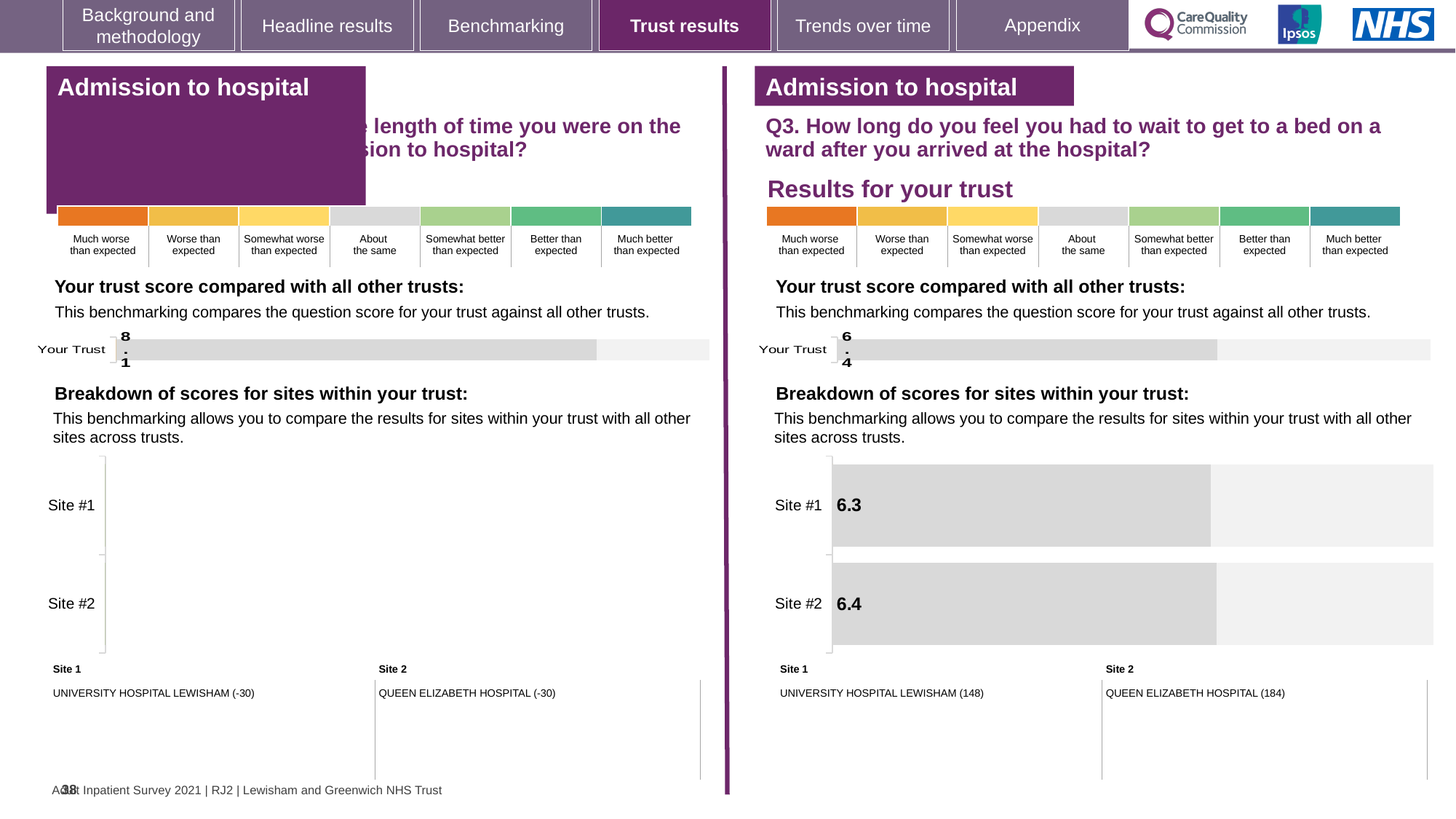
In the right-hand panel (Q3) site breakdown chart, what is the difference between the Site #2 and Site #1 scores? 0.1 In the right-hand panel (Q3) site breakdown chart, what is the score for Site #1? 6.3 In the right-hand panel (Q3), which hospital is listed as Site 2 below the site breakdown chart? QUEEN ELIZABETH HOSPITAL In the right-hand panel (Q3), what is the score shown for Your Trust in the 'Your trust score compared with all other trusts' chart? 6.4 In the right-hand panel (Q3) site breakdown chart, what is the score for Site #2? 6.4 How many sites are shown in the right-hand panel (Q3) site breakdown chart? 2 In the right-hand panel (Q3) site breakdown chart, which site has the lowest score? Site #1 In the left-hand panel, what is the score shown for Your Trust in the 'Your trust score compared with all other trusts' chart? 8.1 Which is larger: the Your Trust score in the left-hand panel or the Your Trust score in the right-hand panel (Q3)? Left-hand panel (8.1) In the right-hand panel (Q3) site breakdown chart, which site has the higher score? Site #2 In the right-hand panel (Q3), which hospital is listed as Site 1 below the site breakdown chart? UNIVERSITY HOSPITAL LEWISHAM What type of chart is used for the site breakdown in the right-hand panel (Q3)? Bar chart